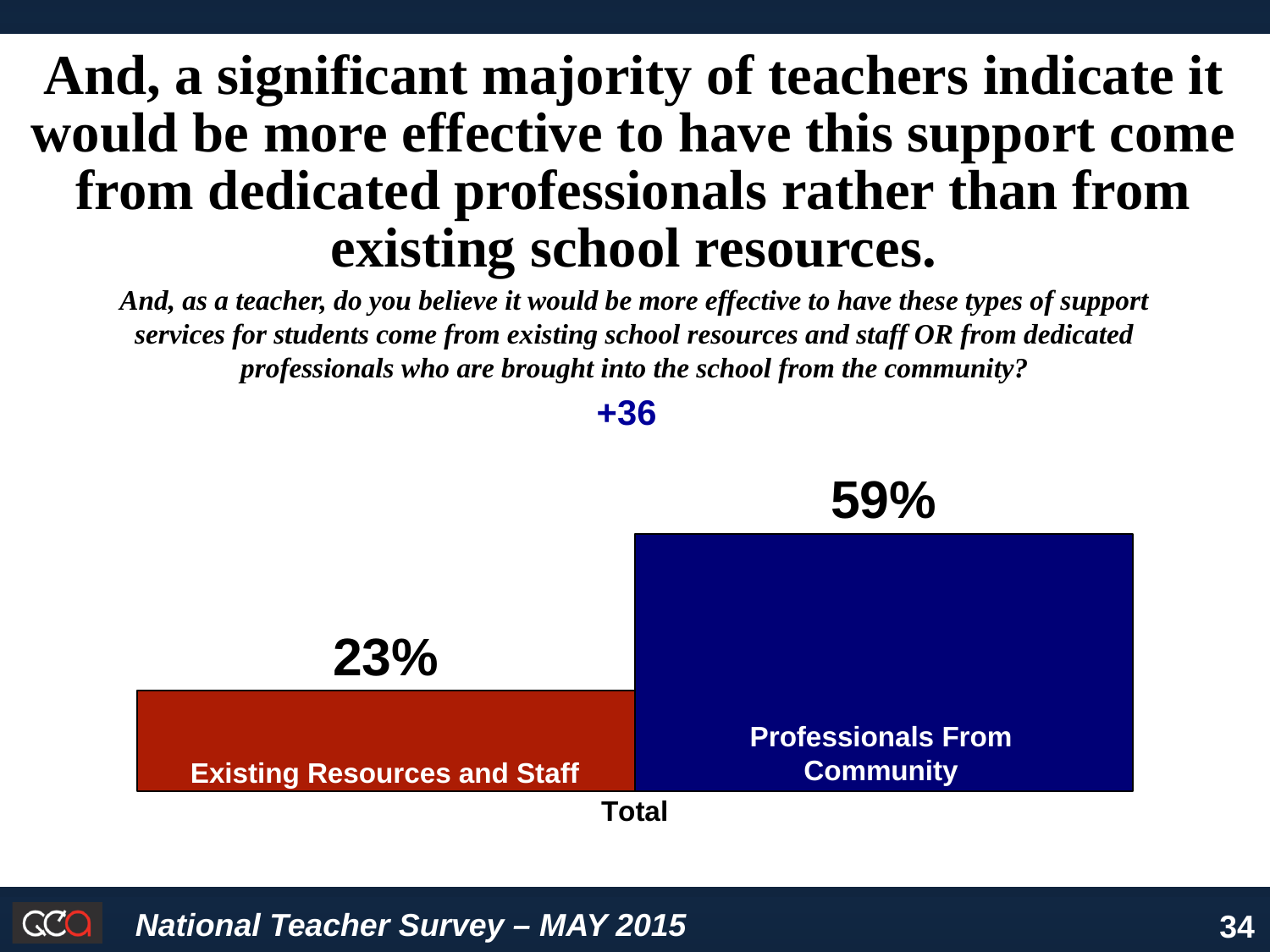
What percentage of teachers chose Existing Resources and Staff? 23% What is the category label shown beneath the bars on the x axis? Total What percentage of teachers chose Professionals From Community? 59% Is the value for Professionals From Community larger or smaller than the value for Existing Resources and Staff? larger What kind of chart is shown on the slide? bar chart What is the difference in percentage points between Professionals From Community and Existing Resources and Staff? 36 What colour is the bar for Professionals From Community? blue What is the net difference figure printed above the chart? +36 Which option received the lower share of teachers? Existing Resources and Staff How many bars are shown in the chart? 2 Which option received the higher share of teachers? Professionals From Community